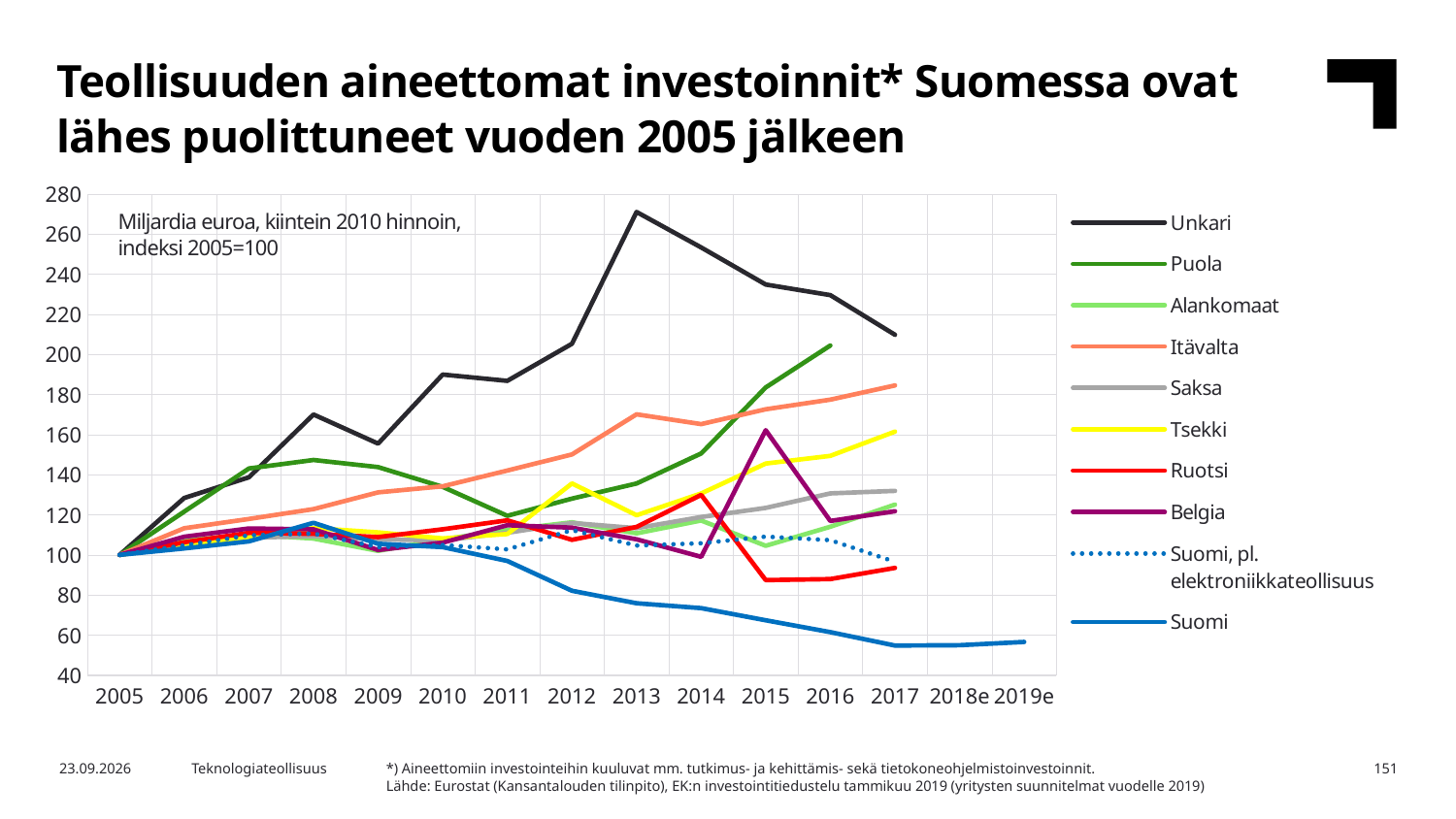
How many years are shown on the x axis? 15 Which country has the highest value in 2013? Unkari Is the value for Suomi in 2017 greater or less than 60? less Which series has the lowest value in 2017? Suomi What is the value of every series in 2005? 100 Does the Suomi line rise or fall from 2008 to 2017? Fall How many series does the legend list? 10 Is the value for Unkari in 2013 greater or less than 260? greater Which is larger in 2016, Puola or Tsekki? Puola Which series is drawn with a dotted line? Suomi, pl. elektroniikkateollisuus Is the value for Ruotsi in 2015 greater or less than 100? less What kind of chart is shown on the slide? Line chart